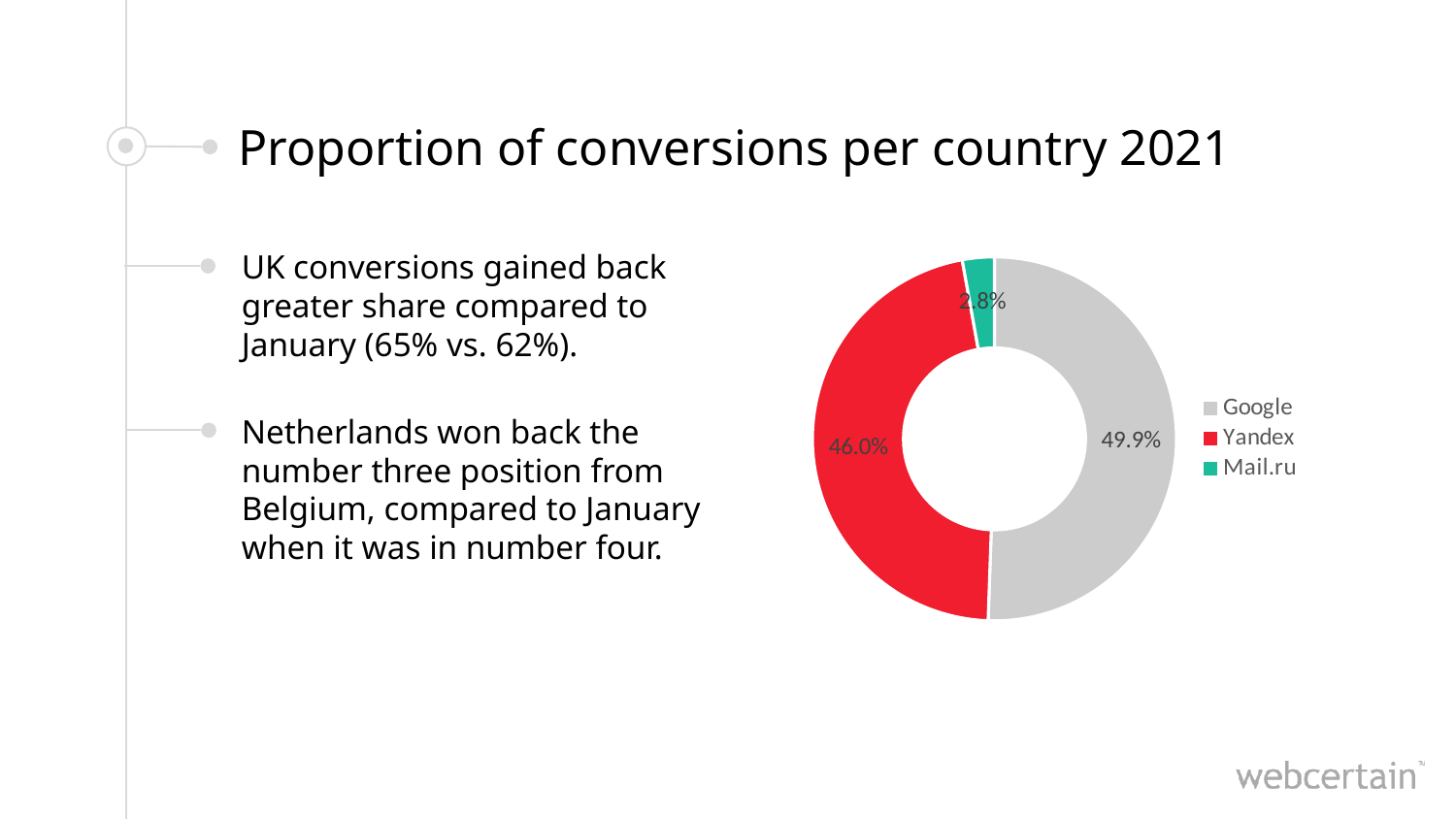
How many slices does the pie chart have? 3 What colour is the Yandex slice in the chart? Red Which search engine has the largest slice of the pie? Google Which slice is larger, Google or Yandex? Google What is the difference in percentage points between the Yandex and Mail.ru slices? 43.2 What share of the pie does Google have? 49.9% What share of the pie does Mail.ru have? 2.8% What share of the pie does Yandex have? 46.0% What is the difference in percentage points between the Google and Yandex slices? 3.9 How many entries does the legend list? 3 What kind of chart is shown on the slide? Pie chart (doughnut) Which search engine has the smallest slice of the pie? Mail.ru